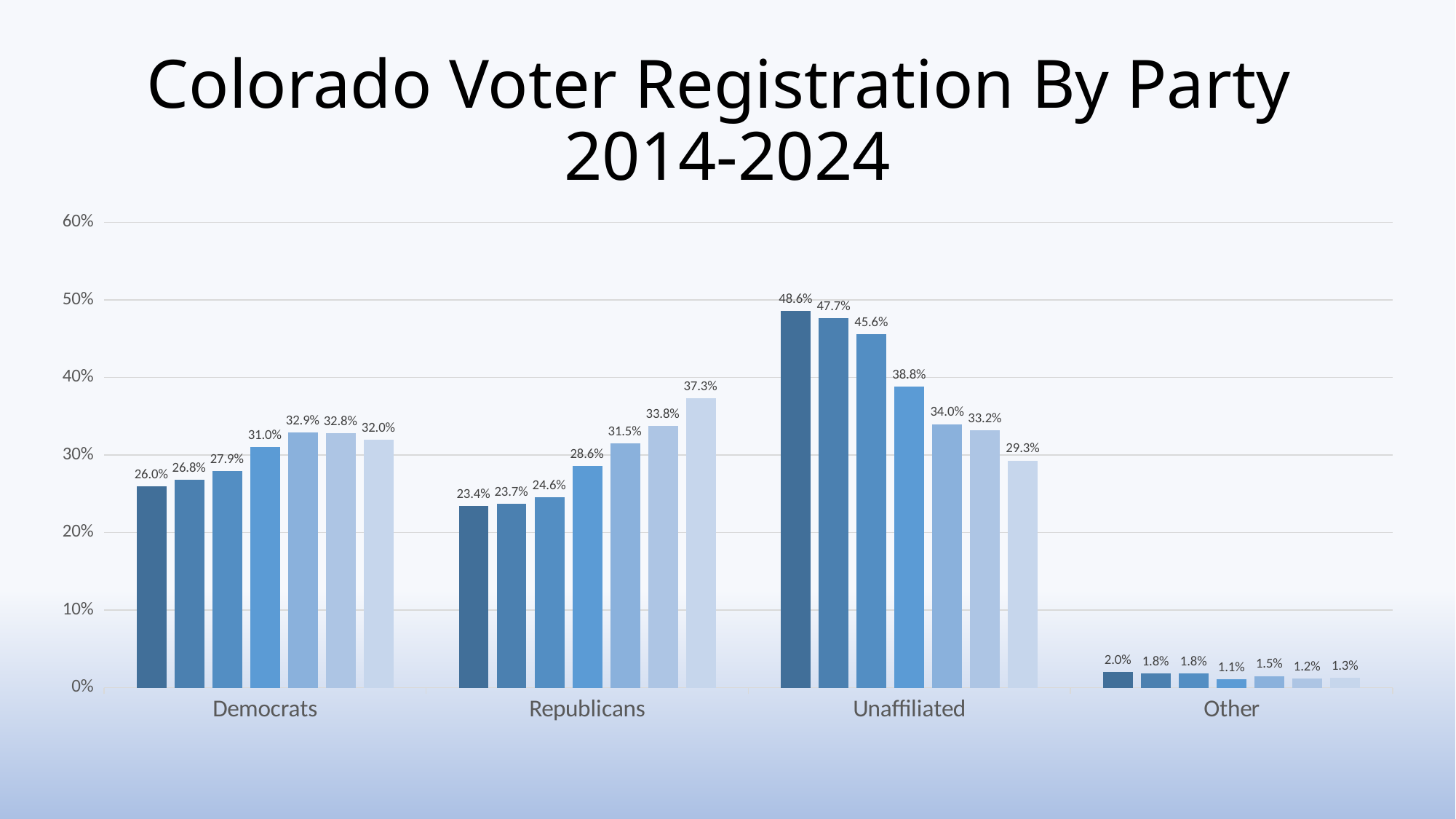
Within the Unaffiliated group, do the bars rise or fall from left to right? fall How many bars are plotted for each party category? 7 Which party category has the tallest bar on the chart? Unaffiliated What kind of chart is shown on the slide? bar chart What is the title of the chart? Colorado Voter Registration By Party 2014-2024 What is the value of the leftmost bar in the Unaffiliated group? 48.6% What is the value of the leftmost bar in the Democrats group? 26.0% What is the difference between the leftmost bar (48.6%) and the rightmost bar (29.3%) in the Unaffiliated group? 19.3 percentage points Which is larger: the rightmost bar for Democrats or the rightmost bar for Republicans? Republicans What is the value of the rightmost bar in the Republicans group? 37.3% Which party category has the lowest values on the chart? Other How many party categories are shown on the x axis? 4